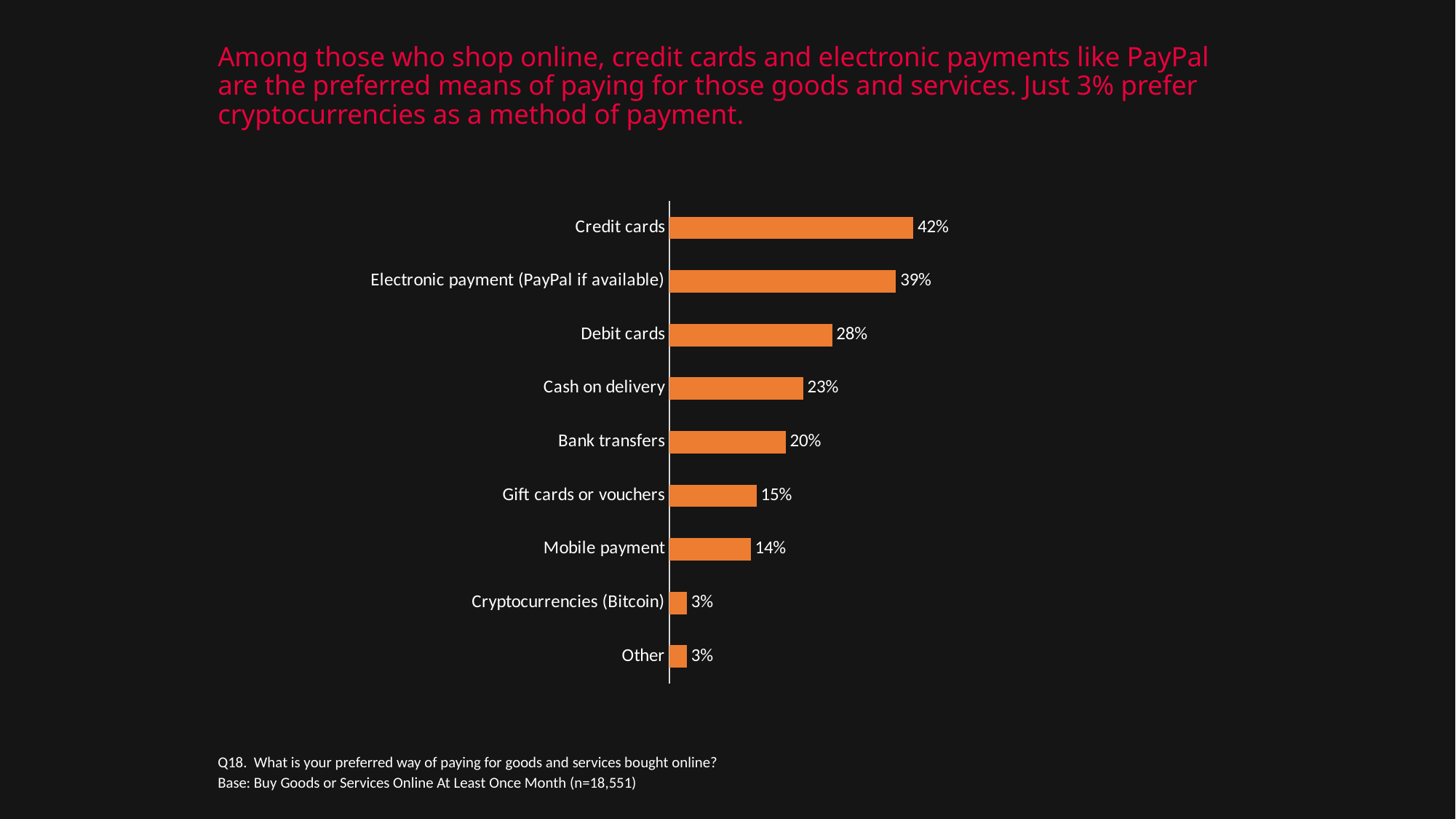
What is the difference in percentage points between Credit cards and Electronic payment (PayPal if available)? 3 How many payment methods are shown in the chart? 9 What is the value for Mobile payment? 14% What percentage prefer Cash on delivery? 23% What percentage prefer credit cards as their way of paying for goods and services bought online? 42% What kind of chart is shown on the slide? Bar chart What is the value shown for Debit cards? 28% What is the difference between Bank transfers and Gift cards or vouchers? 5% Which is larger, Gift cards or vouchers or Mobile payment? Gift cards or vouchers Which payment method has the highest percentage? Credit cards Which is larger, the value for Debit cards or the value for Cash on delivery? Debit cards What colour are the bars in the chart? Orange